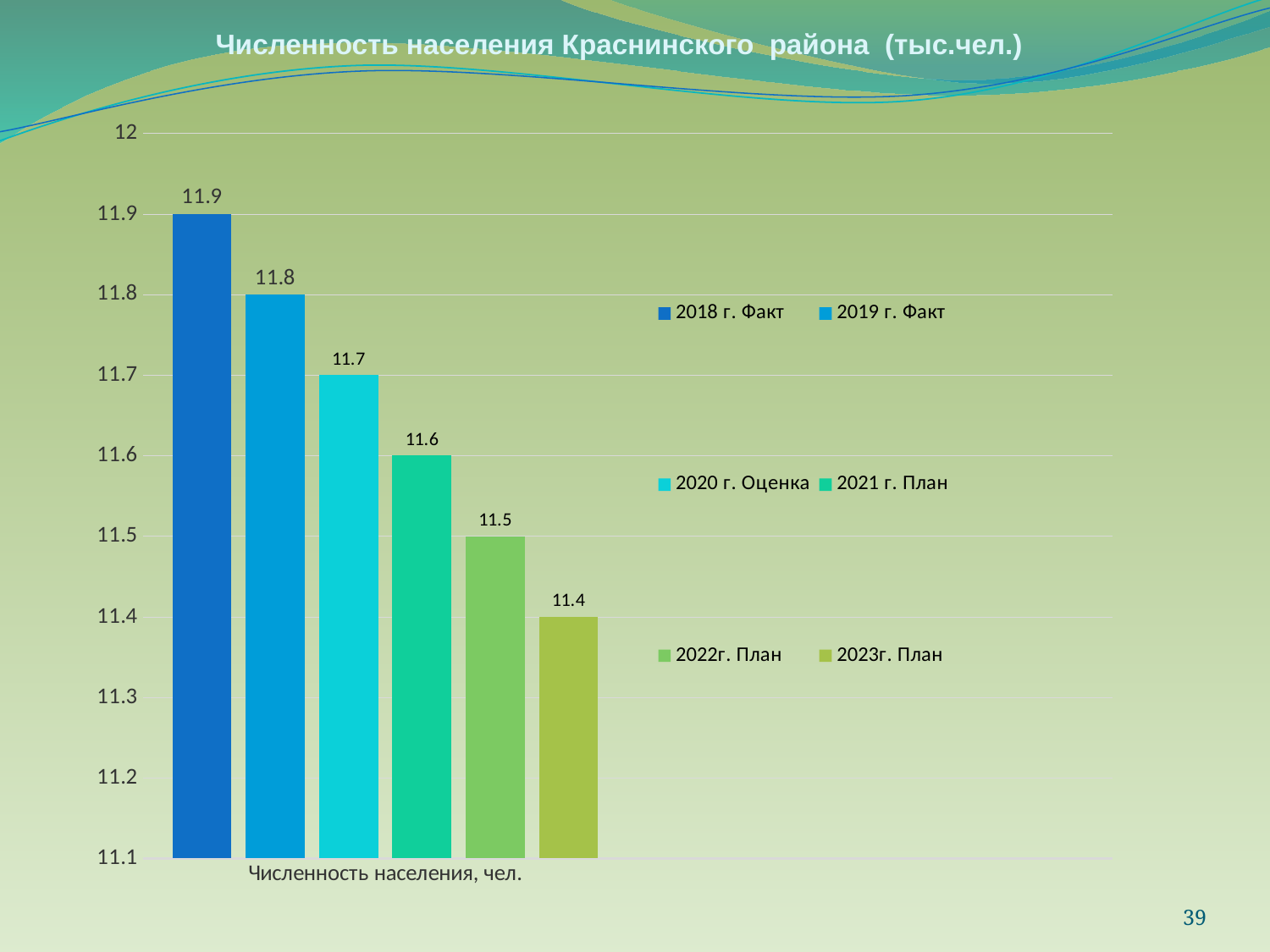
Which series has the highest value? 2018 г. Факт Which is larger, the value for 2019 г. Факт or the value for 2021 г. План? 2019 г. Факт What is the value for 2018 г. Факт? 11.9 What is the value for 2020 г. Оценка? 11.7 What is the value for 2023г. План? 11.4 Do the values rise or fall from 2018 г. Факт to 2023г. План? fall What is the difference between the values for 2018 г. Факт and 2023г. План? 0.5 Is the value for 2022г. План greater or less than 11.6? less How many series does the legend list? 6 How many bars are plotted on the chart? 6 What kind of chart is shown on the slide? bar chart Which series has the lowest value? 2023г. План